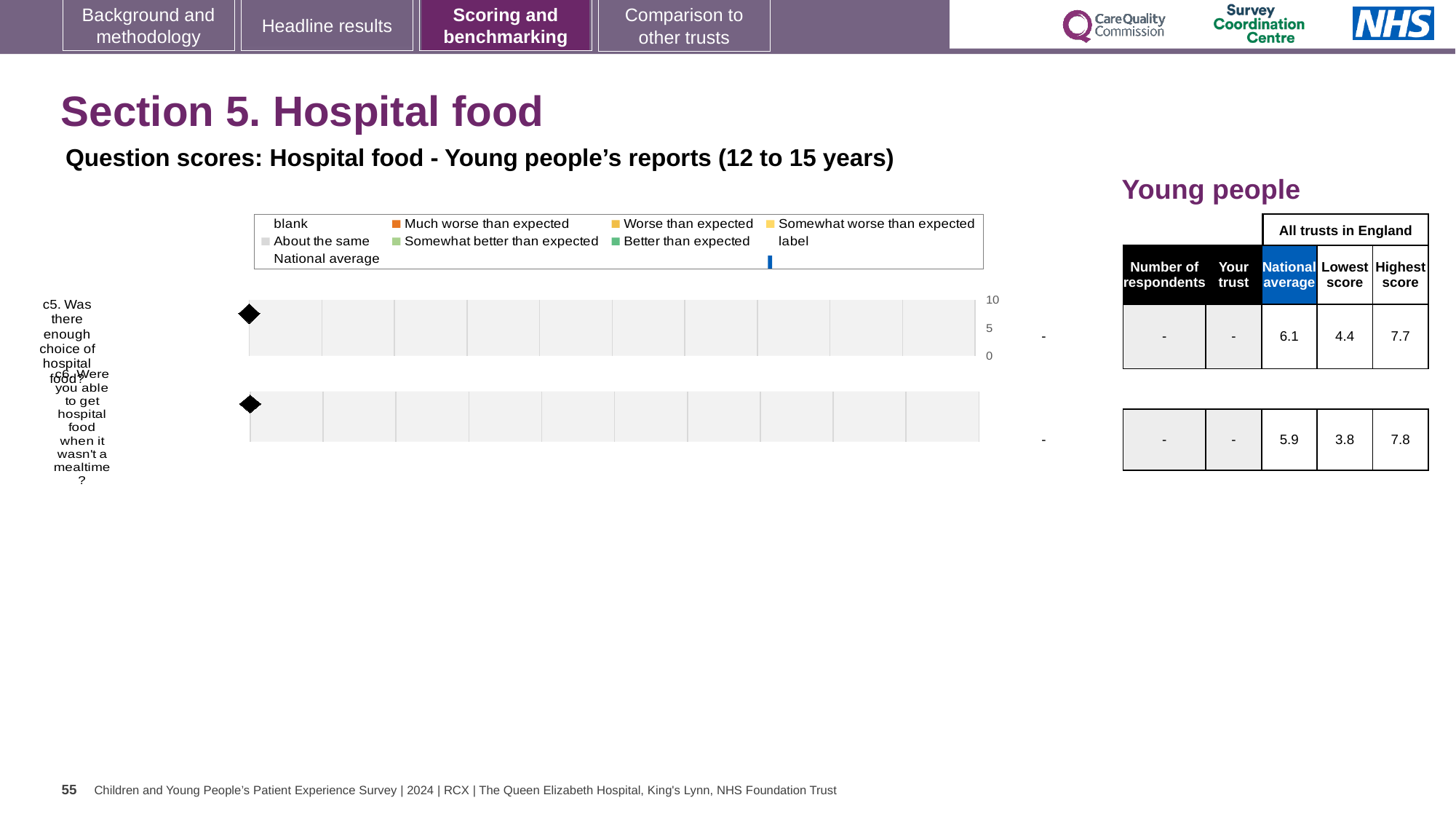
What is the lowest score across all trusts in England for question c5? 4.4 What is the highest score across all trusts in England for question c6? 7.8 Which question has the higher national average, c5 or c6? c5 What value is shown for 'Your trust' for question c5? - What is the national average score for question c5 (Was there enough choice of hospital food?)? 6.1 What kind of chart is used to show the question scores? bar chart What is the national average score for question c6 (Were you able to get hospital food when it wasn't a mealtime?)? 5.9 What is the difference between the highest and lowest trust scores for question c5? 3.3 How many questions (categories) are plotted on the chart? 2 What is the highest value shown on the chart's vertical axis? 10 What is the difference between the highest and lowest trust scores for question c6? 4.0